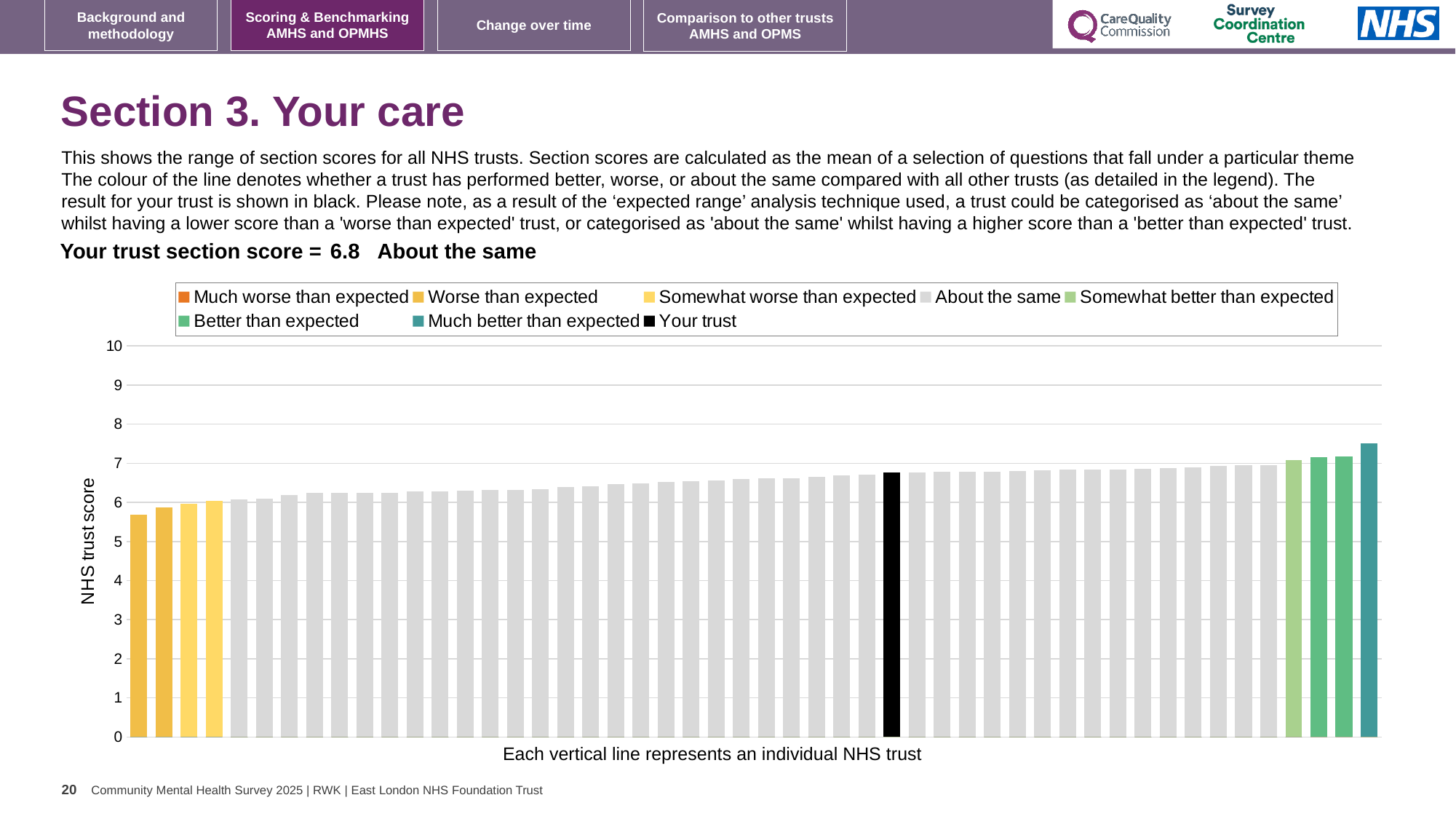
Is the value of the rightmost (highest) bar greater or less than 7? greater What is the highest value shown on the vertical axis? 10 Is the value of the leftmost (lowest) bar greater or less than 6? less What is the label on the vertical axis of the chart? NHS trust score Is the value of the black 'Your trust' bar greater or less than 6? greater How many entries does the chart legend list? 8 Which category is your trust placed in according to the slide? About the same What is the section score for your trust shown on the slide? 6.8 Do the bar values rise or fall from left to right along the x axis? rise What kind of chart is shown on the slide? bar chart